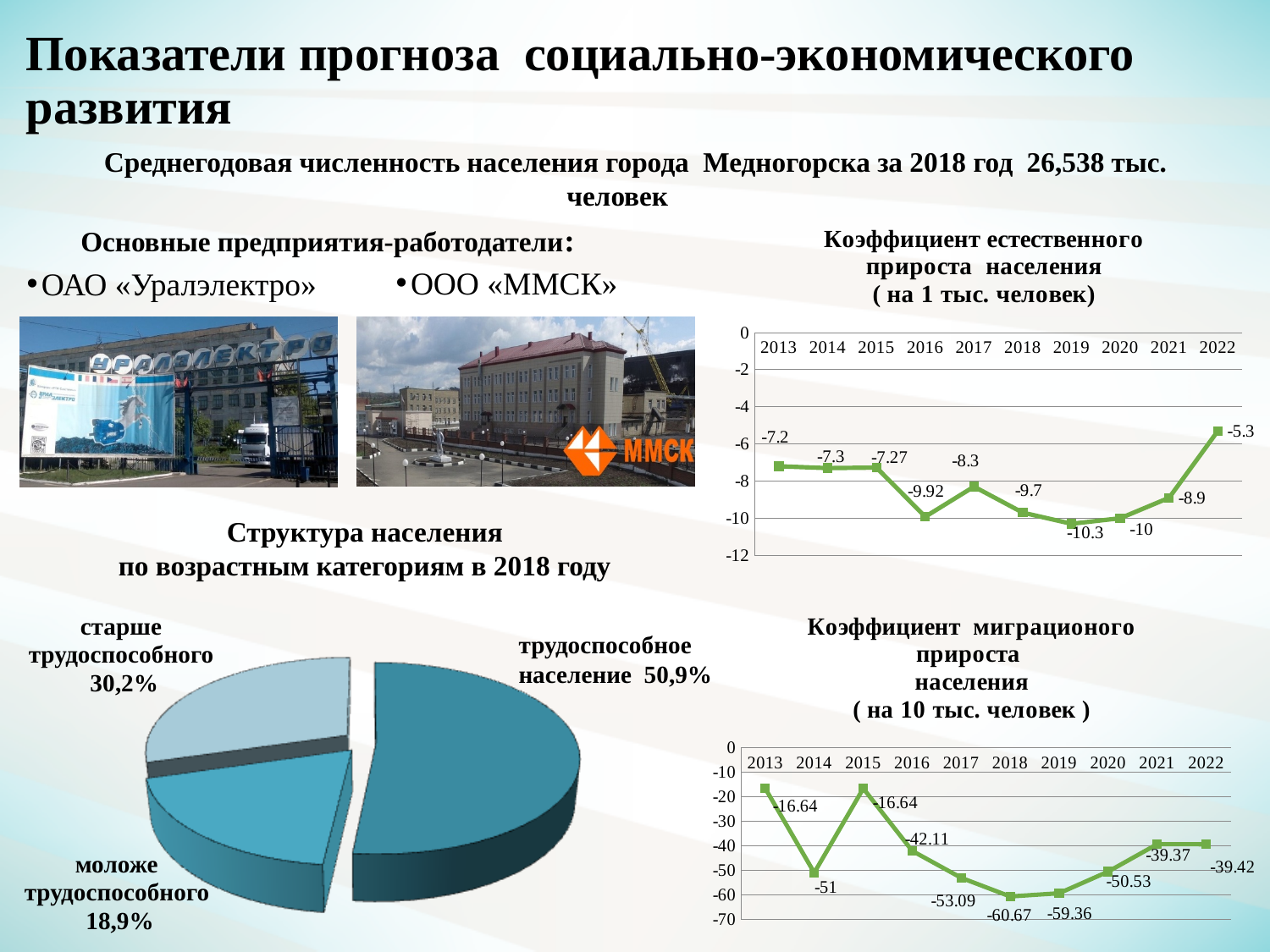
On the chart 'Коэффициент естественного прироста населения', what is the value for 2016? -9.92 On the chart 'Коэффициент естественного прироста населения', what is the difference between the values for 2022 and 2019? 5 On the chart 'Коэффициент естественного прироста населения', which year has the lowest value? 2019 On the chart 'Коэффициент естественного прироста населения', which year has the highest value? 2022 On the chart 'Коэффициент миграционого прироста населения', what is the value for 2018? -60.67 On the chart 'Коэффициент миграционого прироста населения', which is larger, the value for 2014 or the value for 2016? 2016 On the chart 'Коэффициент естественного прироста населения', how many years are plotted? 10 On the pie chart 'Структура населения по возрастным категориям в 2018 году', which category has the smallest share? моложе трудоспособного What kind of chart is 'Коэффициент миграционого прироста населения'? line chart On the chart 'Коэффициент миграционого прироста населения', which year has the lowest value? 2018 On the pie chart 'Структура населения по возрастным категориям в 2018 году', what share is 'трудоспособное население'? 50,9% On the chart 'Коэффициент миграционого прироста населения', what is the difference between the values for 2013 and 2014? 34.36